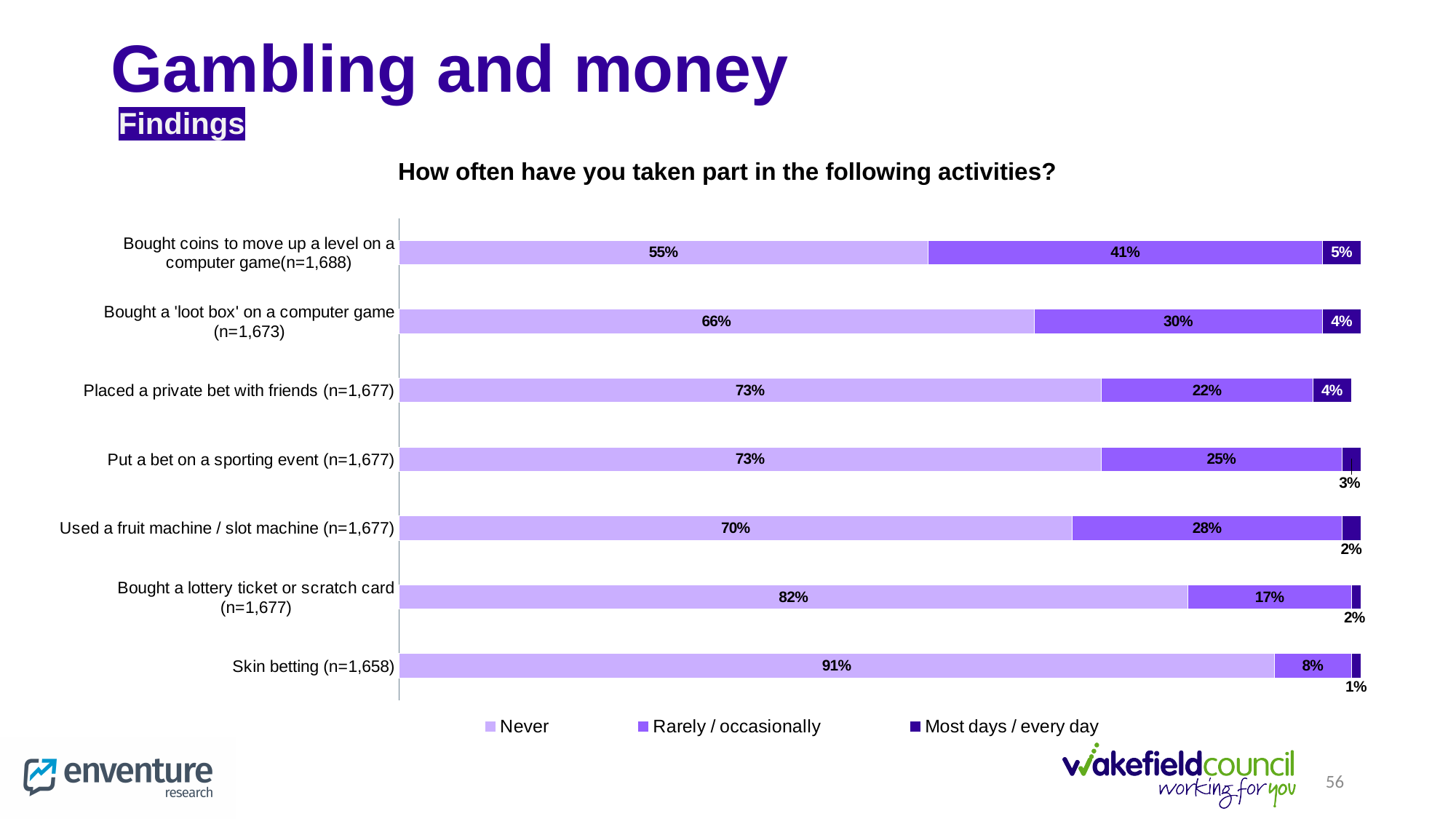
How many series does the legend list? 3 Which activity has the highest 'Most days / every day' percentage? Bought coins to move up a level on a computer game(n=1,688) What percentage of respondents said they 'Never' bought coins to move up a level on a computer game? 55% What percentage of respondents said they took part in skin betting 'Most days / every day'? 1% What percentage of respondents said they 'Rarely / occasionally' bought a 'loot box' on a computer game? 30% What type of chart is shown on the slide? Stacked bar chart What is the title of the chart? How often have you taken part in the following activities? What is the difference between the 'Never' percentage for 'Bought a lottery ticket or scratch card' and for 'Used a fruit machine / slot machine'? 12% Which is larger: the 'Rarely / occasionally' percentage for 'Put a bet on a sporting event' or for 'Placed a private bet with friends'? Put a bet on a sporting event (n=1,677) Which activity has the lowest 'Never' percentage? Bought coins to move up a level on a computer game(n=1,688) How many activities are shown in the chart? 7 Which activity has the highest 'Never' percentage? Skin betting (n=1,658)